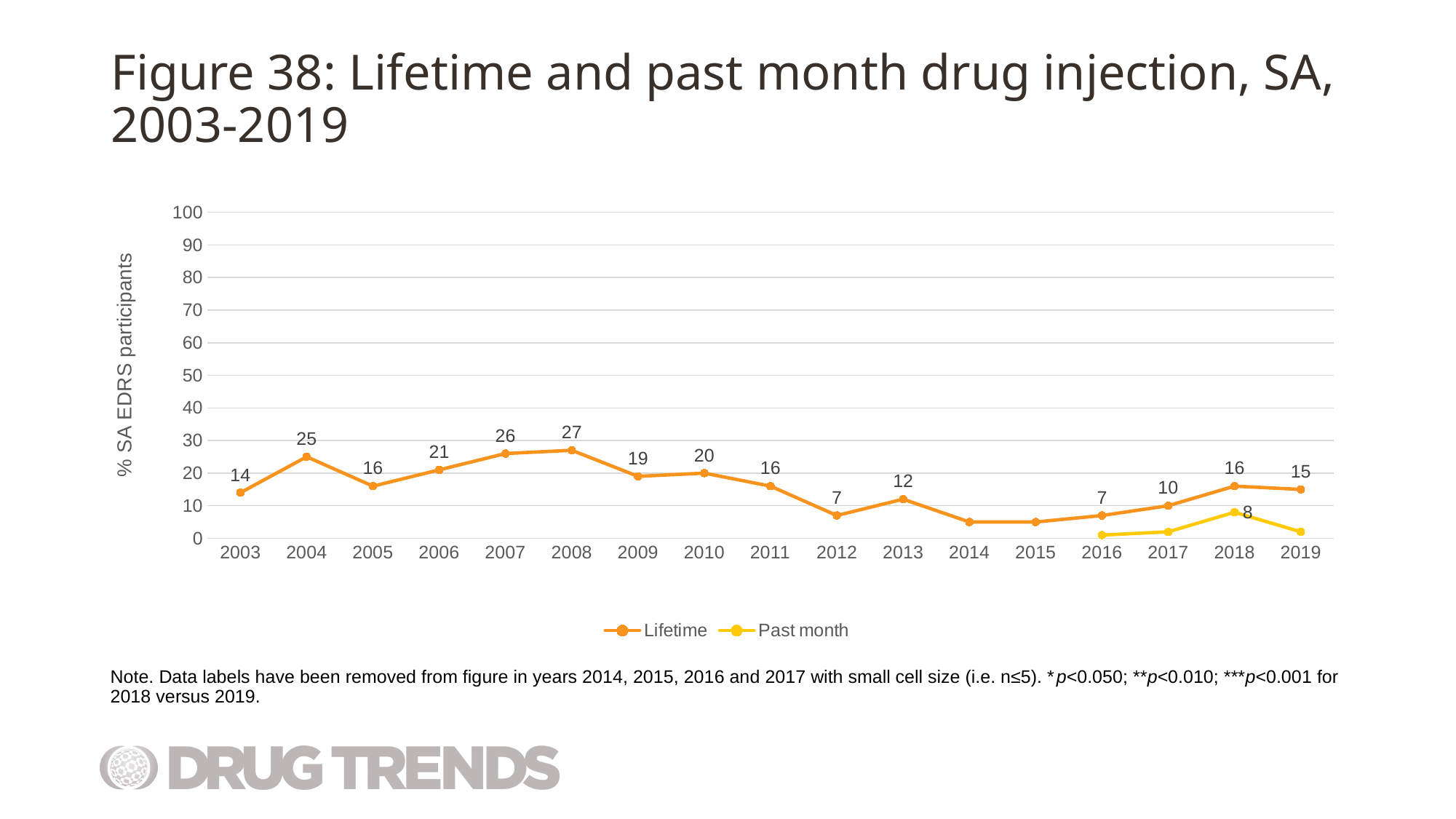
How many years are shown on the x axis? 17 In which year is the Lifetime series highest? 2008 What kind of chart is this? line chart Does the Lifetime series rise or fall from 2008 to 2012? fall Is the Lifetime value for 2014 greater or less than 10? less Is the Past month value for 2016 greater or less than 10? less Which is larger, the Lifetime value for 2007 or the Lifetime value for 2013? 2007 How many series does the legend list? 2 What is the Lifetime value for 2008? 27 What is the difference between the Lifetime values for 2004 and 2005? 9 What is the Lifetime value for 2012? 7 What is the Past month value for 2018? 8